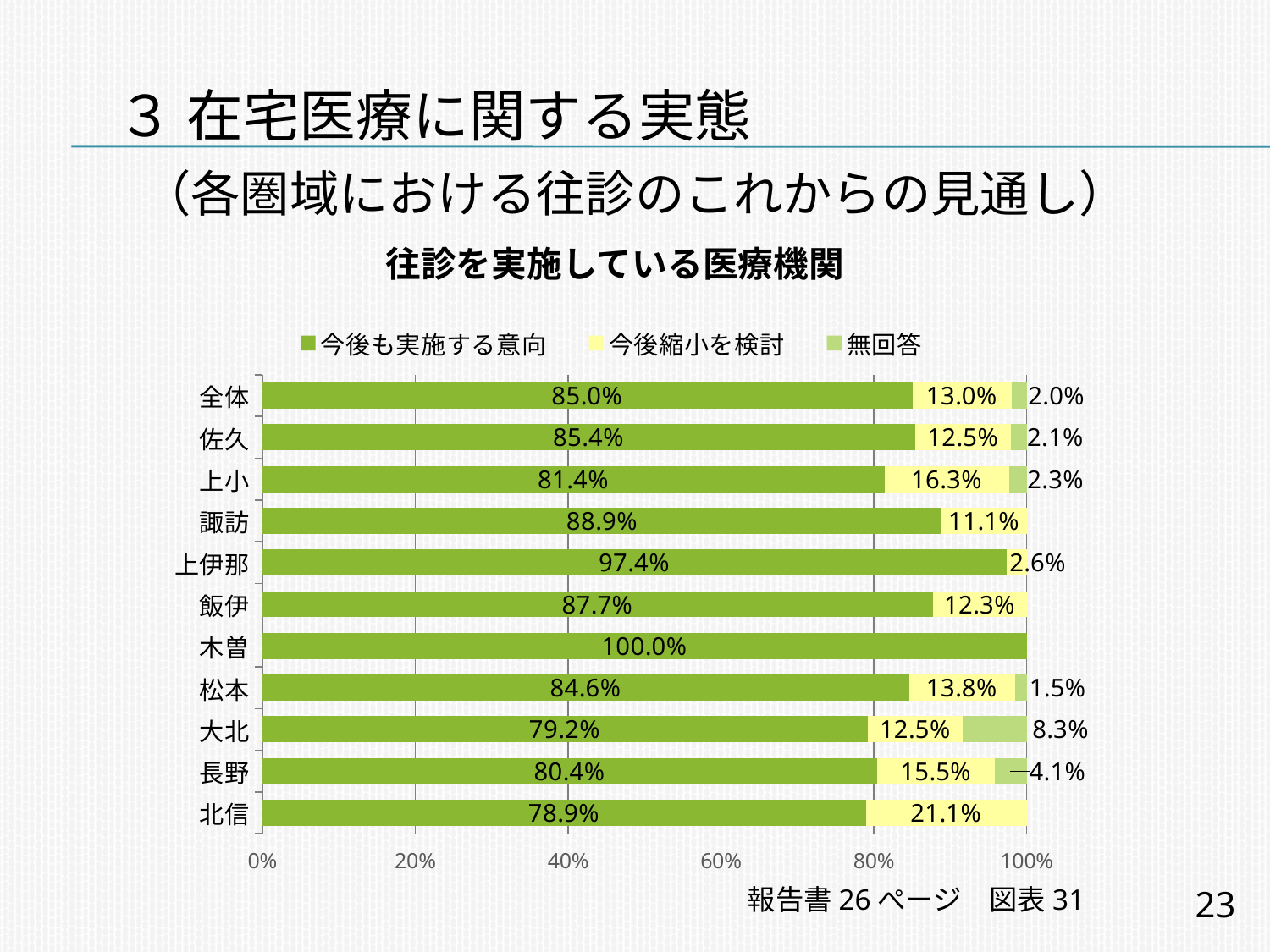
How many categories (regions) are plotted on the chart? 11 What is the difference between the 今後も実施する意向 values for 上伊那 and 上小? 16.0% How many series does the legend list? 3 What kind of chart is shown on the slide? Stacked bar chart What is the value of 今後縮小を検討 for 上伊那? 2.6% Which region has the lowest value for 今後も実施する意向? 北信 Which region has the highest value for 今後も実施する意向? 木曽 Which is larger, the 今後縮小を検討 value for 長野 or for 松本? 長野 What is the value of 今後縮小を検討 for 北信? 21.1% What is the value of 今後も実施する意向 for 全体? 85.0% What is the value of 無回答 for 大北? 8.3% What is the title of the chart? 往診を実施している医療機関